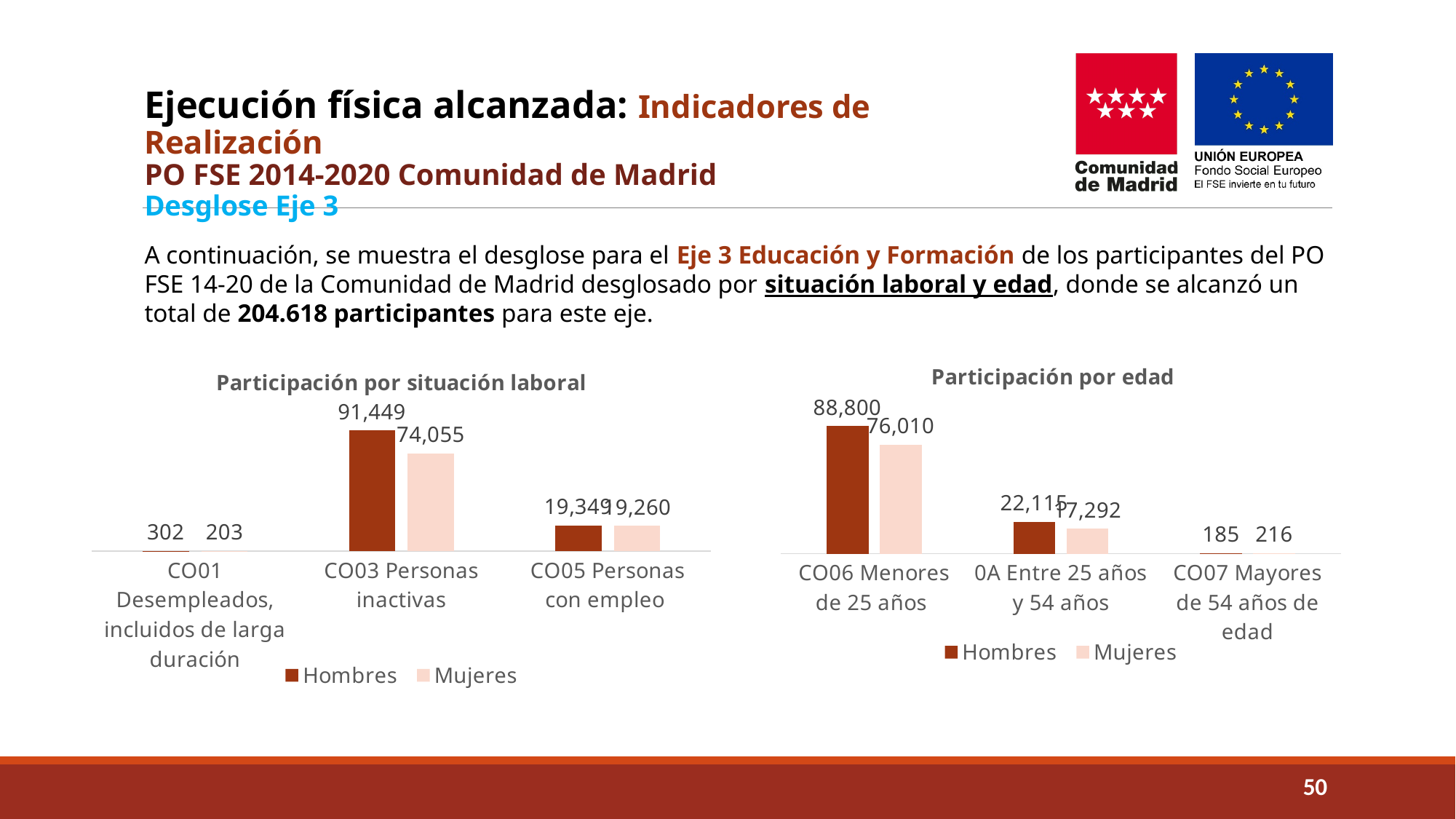
In the 'Participación por edad' chart, what is the value for Mujeres in CO06 Menores de 25 años? 76,010 In the 'Participación por situación laboral' chart, what is the value for Hombres in CO03 Personas inactivas? 91,449 In the 'Participación por edad' chart, what is the value for Hombres in CO06 Menores de 25 años? 88,800 What type of chart is 'Participación por edad'? Bar chart In the 'Participación por edad' chart, how many series does the legend list? 2 In the 'Participación por situación laboral' chart, what is the value for Mujeres in CO03 Personas inactivas? 74,055 In the 'Participación por situación laboral' chart, which category has the highest value for Hombres? CO03 Personas inactivas In the 'Participación por edad' chart, which category has the lowest value for Hombres? CO07 Mayores de 54 años de edad In the 'Participación por situación laboral' chart, what is the value for Hombres in CO01 Desempleados, incluidos de larga duración? 302 In the 'Participación por edad' chart, what is the value for Mujeres in CO07 Mayores de 54 años de edad? 216 In the 'Participación por situación laboral' chart, what is the difference between Hombres and Mujeres in CO03 Personas inactivas? 17,394 In the 'Participación por situación laboral' chart, how many categories are shown? 3